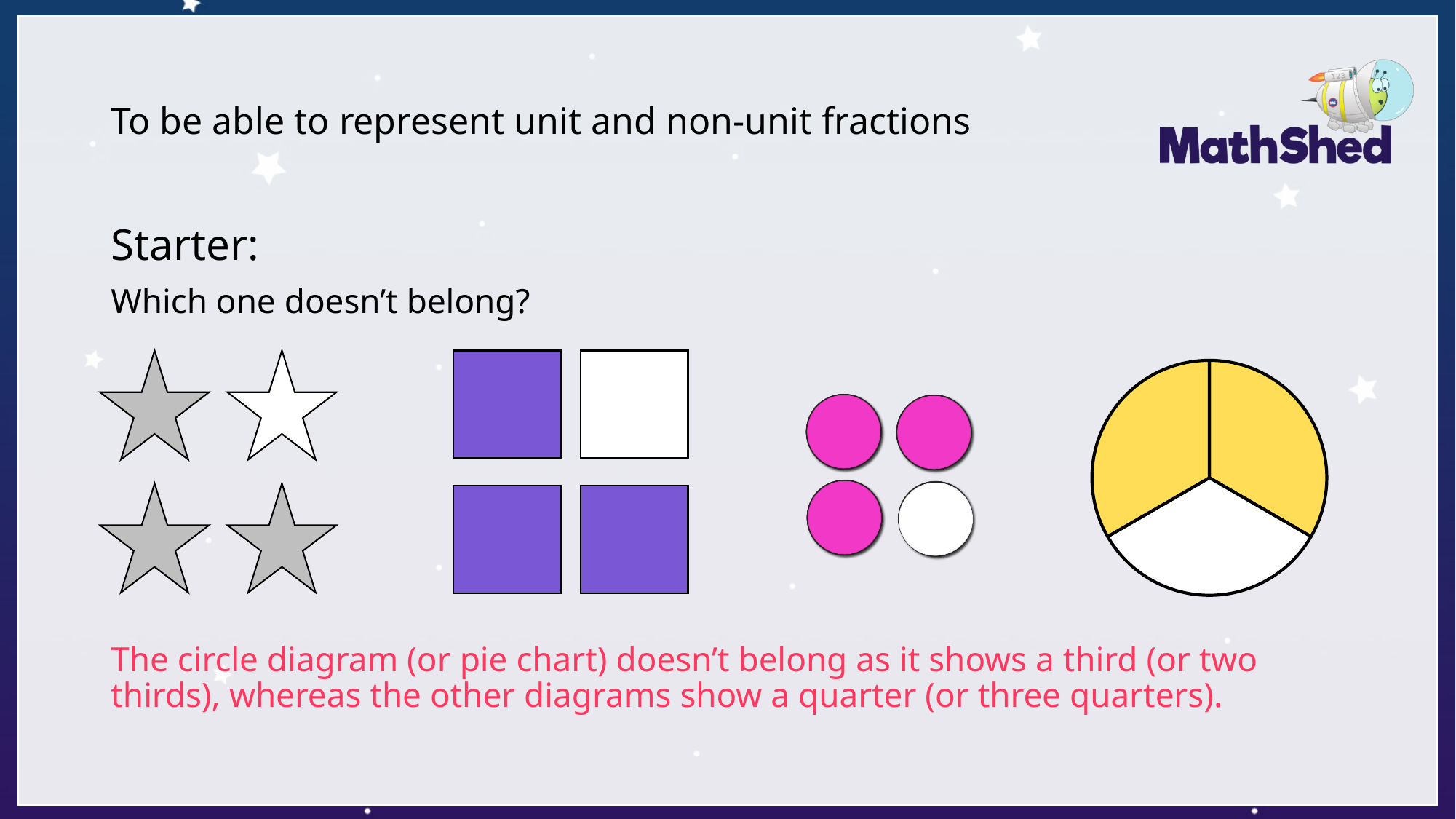
Are the slices of the pie chart equal in size? yes How many slices of the pie chart are shaded yellow? 2 What kind of chart is shown on the right of the slide? pie chart What fraction of the pie chart is left white? a third Which colour covers the larger share of the pie chart, yellow or white? yellow How many slices is the pie chart divided into? 3 What fraction of the pie chart is shaded yellow? two thirds According to the slide, which diagram doesn't belong? the circle diagram (or pie chart)